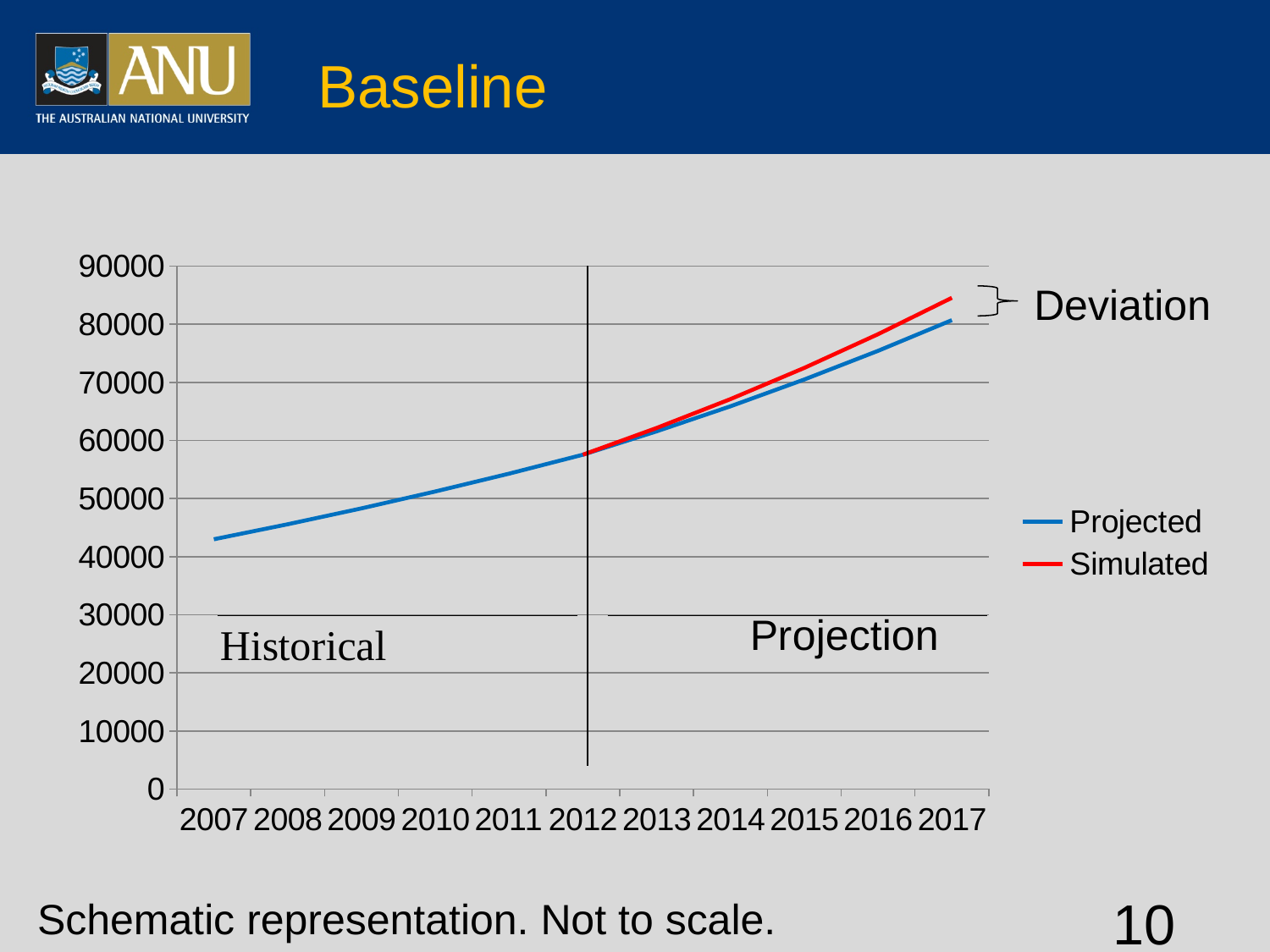
Does the Projected series rise or fall from 2007 to 2017? rise How many years are shown on the x axis? 11 Is the Projected value for 2007 greater or less than 50000? less What colour is the Simulated line? red In which year is the Projected series at its lowest? 2007 Is the Projected value for 2007 greater or less than 40000? greater What is the title of the slide containing the chart? Baseline How many series does the legend list? 2 In 2017, which series has the larger value, Projected or Simulated? Simulated Is the Simulated value for 2017 greater or less than 80000? greater What kind of chart is shown on the slide? line chart